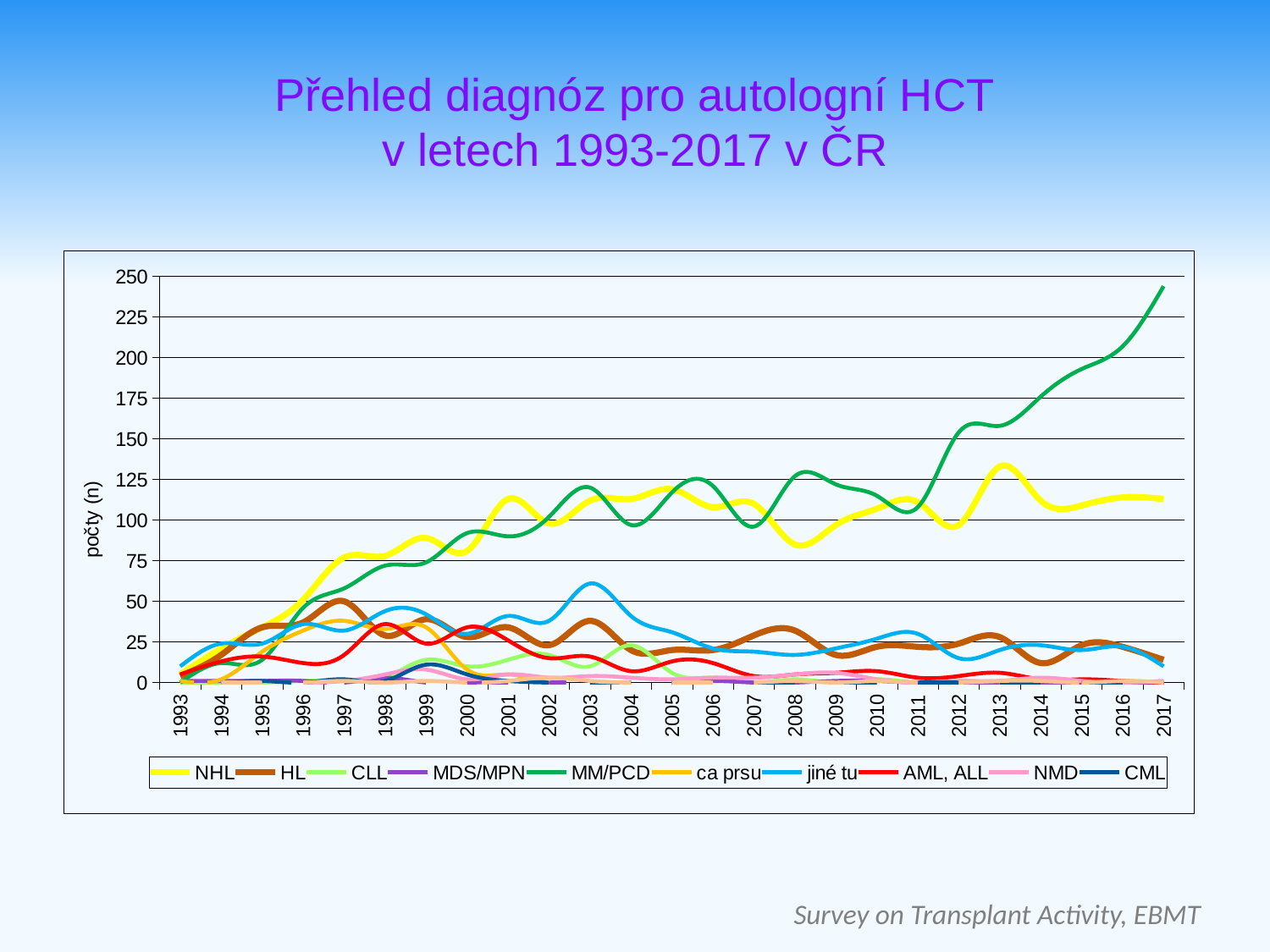
How many series does the legend list? 10 What is the label of the y axis? počty (n) In which year does MM/PCD reach its highest value? 2017 Is the value for jiné tu in 2003 greater or less than 50? greater Is the value for MM/PCD in 2017 greater or less than 225? greater Is the value for NHL in 2017 greater or less than 125? less How many years are shown along the x axis? 25 Does the MM/PCD line rise or fall from 2011 to 2017? rise Which series has the highest value in 2017? MM/PCD In 2008, which is larger: NHL or MM/PCD? MM/PCD What kind of chart is shown on the slide? line chart